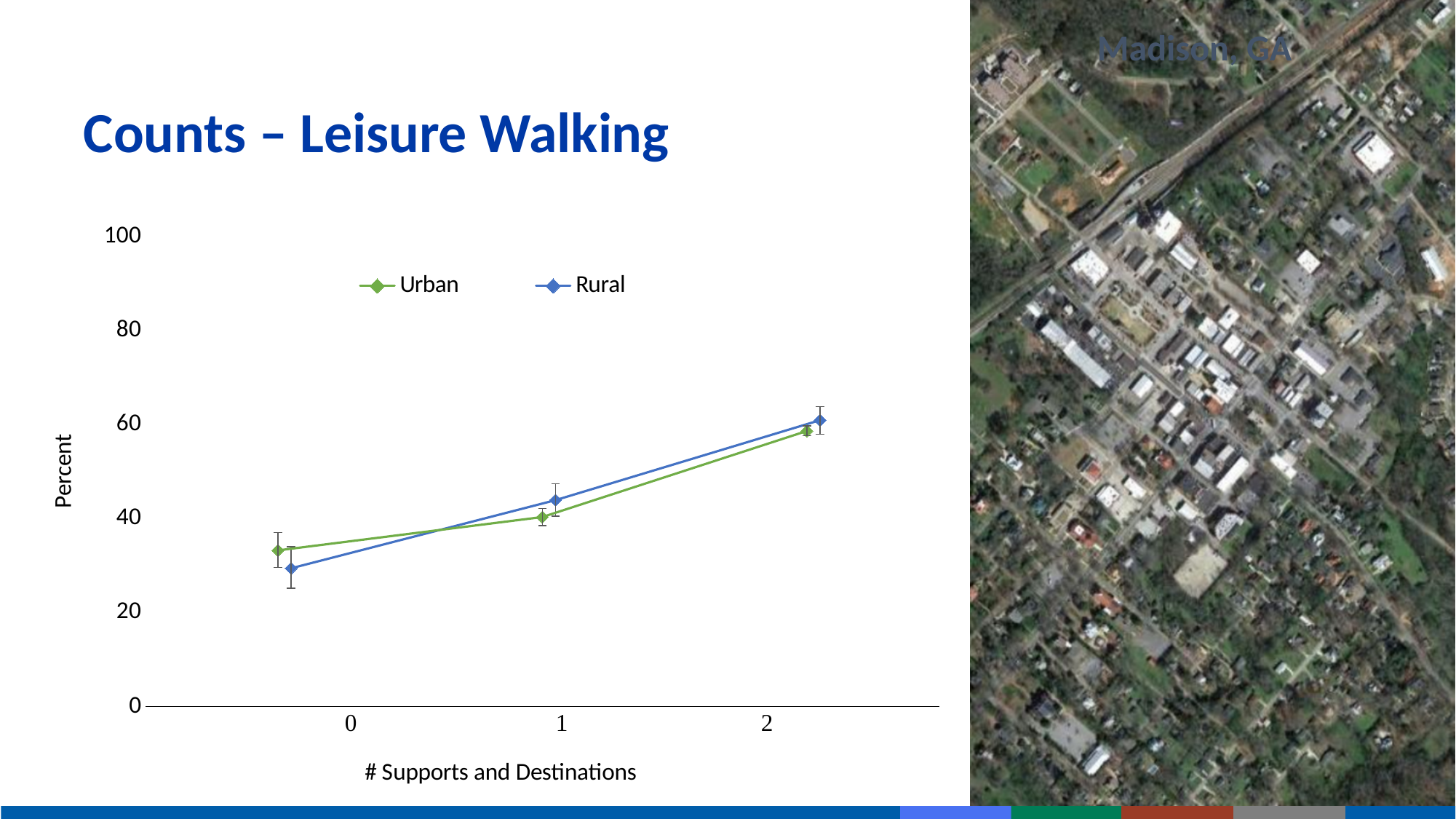
At 0 supports and destinations, which series has the higher value, Urban or Rural? Urban What is the title of the x axis? # Supports and Destinations How many points are plotted for the Urban series? 3 Is the Rural value at 1 supports and destinations greater or less than 60? less Is the Urban value at 2 supports and destinations greater or less than 40? greater Do the Urban values rise or fall as # Supports and Destinations increases from 0 to 2? rise How many series does the legend list? 2 Do the Rural values rise or fall as # Supports and Destinations increases from 0 to 2? rise What is the title of the y axis? Percent Is the Rural value at 0 supports and destinations greater or less than 40? less At 1 supports and destinations, which series has the higher value, Urban or Rural? Rural What kind of chart is shown on the slide? line chart